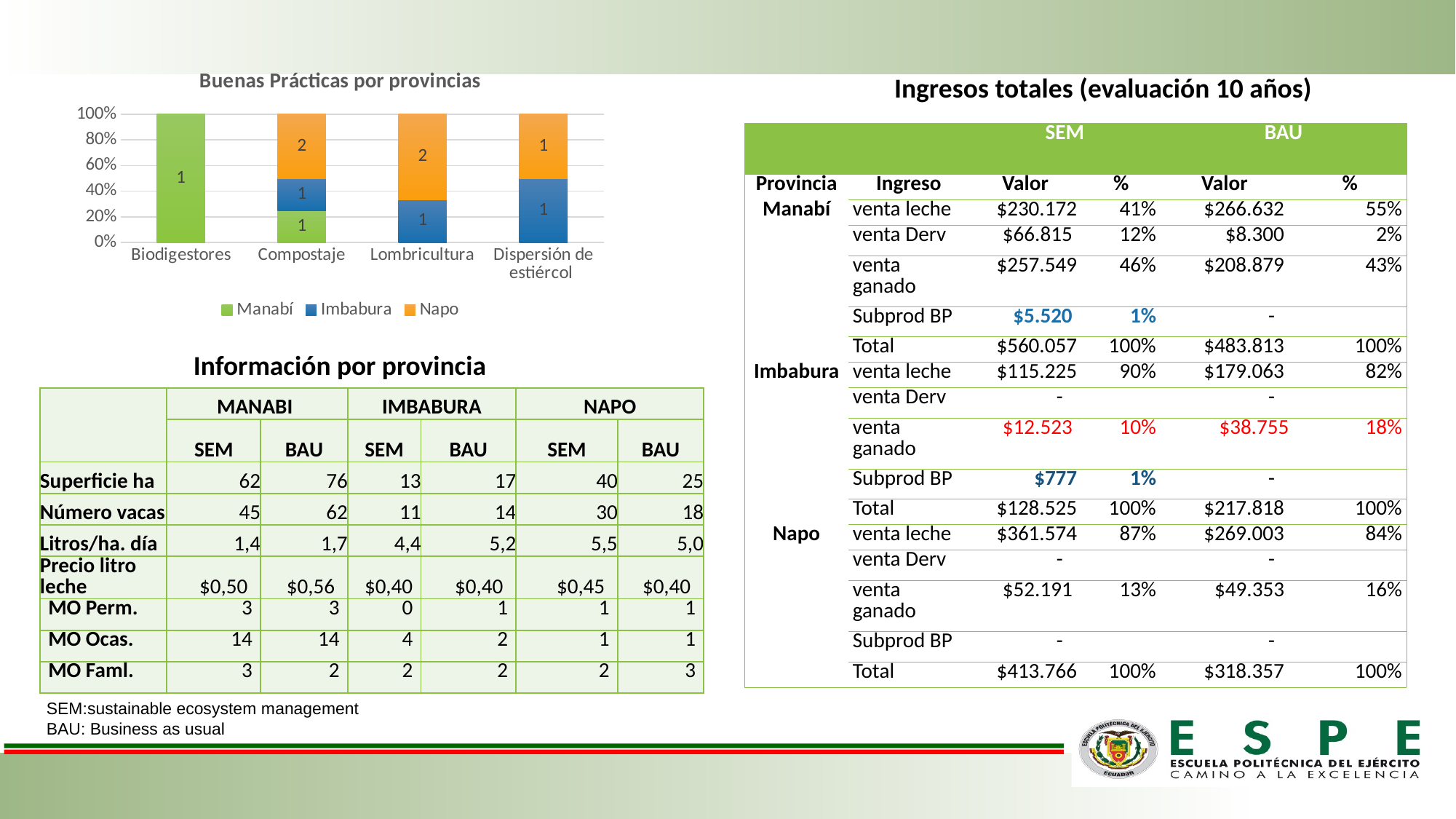
In the 'Buenas Prácticas por provincias' chart, what is the value for Manabí in Biodigestores? 1 In the 'Buenas Prácticas por provincias' chart, what is the total of the Compostaje bar? 4 How many series does the legend of the 'Buenas Prácticas por provincias' chart list? 3 In the 'Buenas Prácticas por provincias' chart, what is the value for Imbabura in Lombricultura? 1 In the 'Buenas Prácticas por provincias' chart, what is the difference between the Napo value and the Imbabura value in Lombricultura? 1 How many categories are shown on the x axis of the 'Buenas Prácticas por provincias' chart? 4 In the 'Buenas Prácticas por provincias' chart, what is the total of the Lombricultura bar? 3 In the 'Buenas Prácticas por provincias' chart, which category has the highest total count of practices? Compostaje In the 'Buenas Prácticas por provincias' chart, which is larger in Compostaje: the Napo value or the Manabí value? Napo In the 'Buenas Prácticas por provincias' chart, what is the value for Napo in Compostaje? 2 In the 'Buenas Prácticas por provincias' chart, which series is shown in orange? Napo What type of chart is 'Buenas Prácticas por provincias'? Stacked bar chart